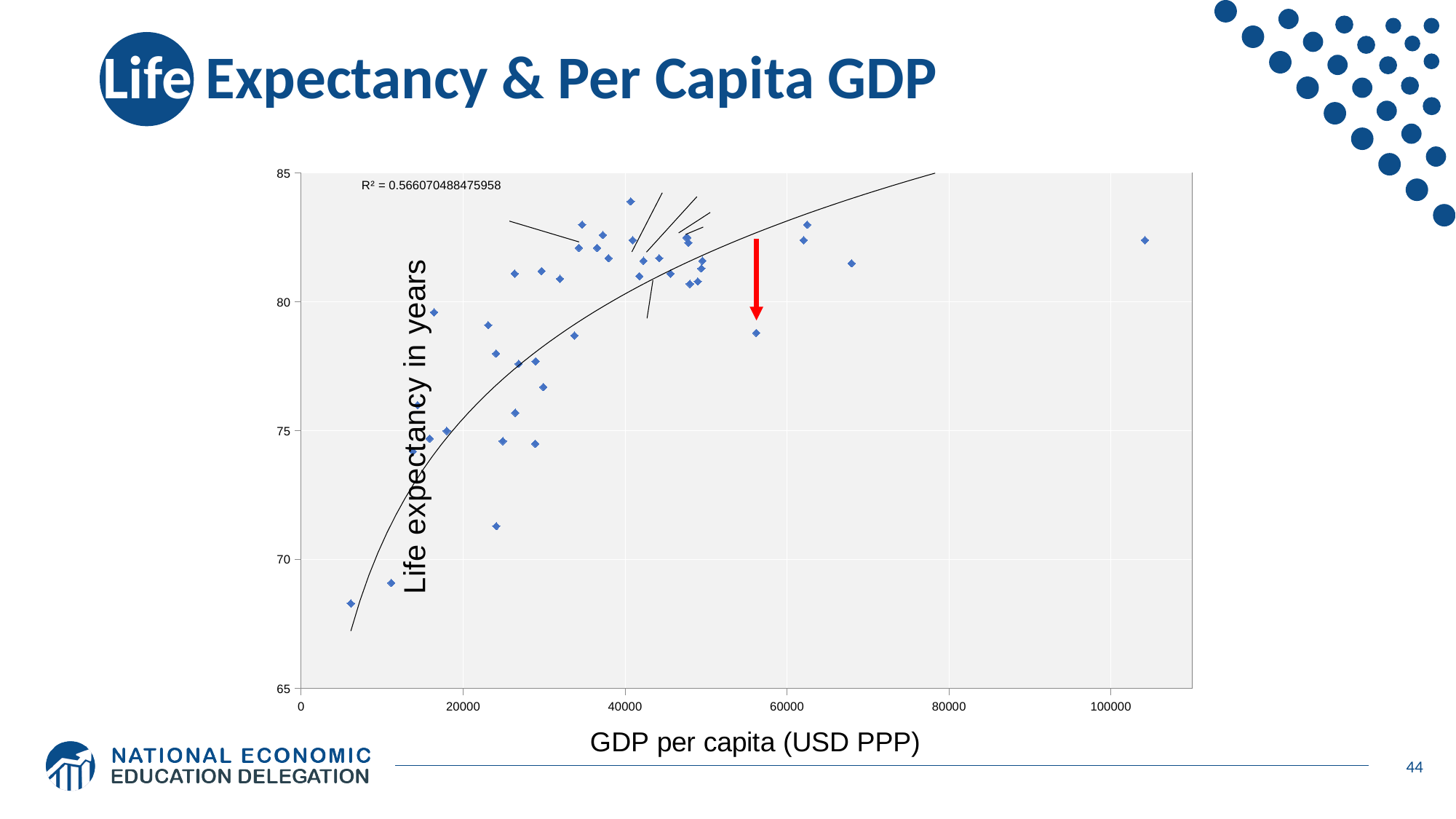
Is the life expectancy of the point with the highest GDP per capita (beyond 100000) greater or less than 80? greater What is the R² value printed on the chart? R² = 0.566070488475958 What is the title of the slide's chart? Life Expectancy & Per Capita GDP Is the life expectancy of the point marked by the red arrow greater or less than 80? less Is the GDP per capita of the point marked by the red arrow greater or less than 40000? greater Does life expectancy generally rise or fall as GDP per capita increases along the x axis? rise What is the highest value shown on the y axis? 85 What kind of chart is shown on the slide? scatter chart